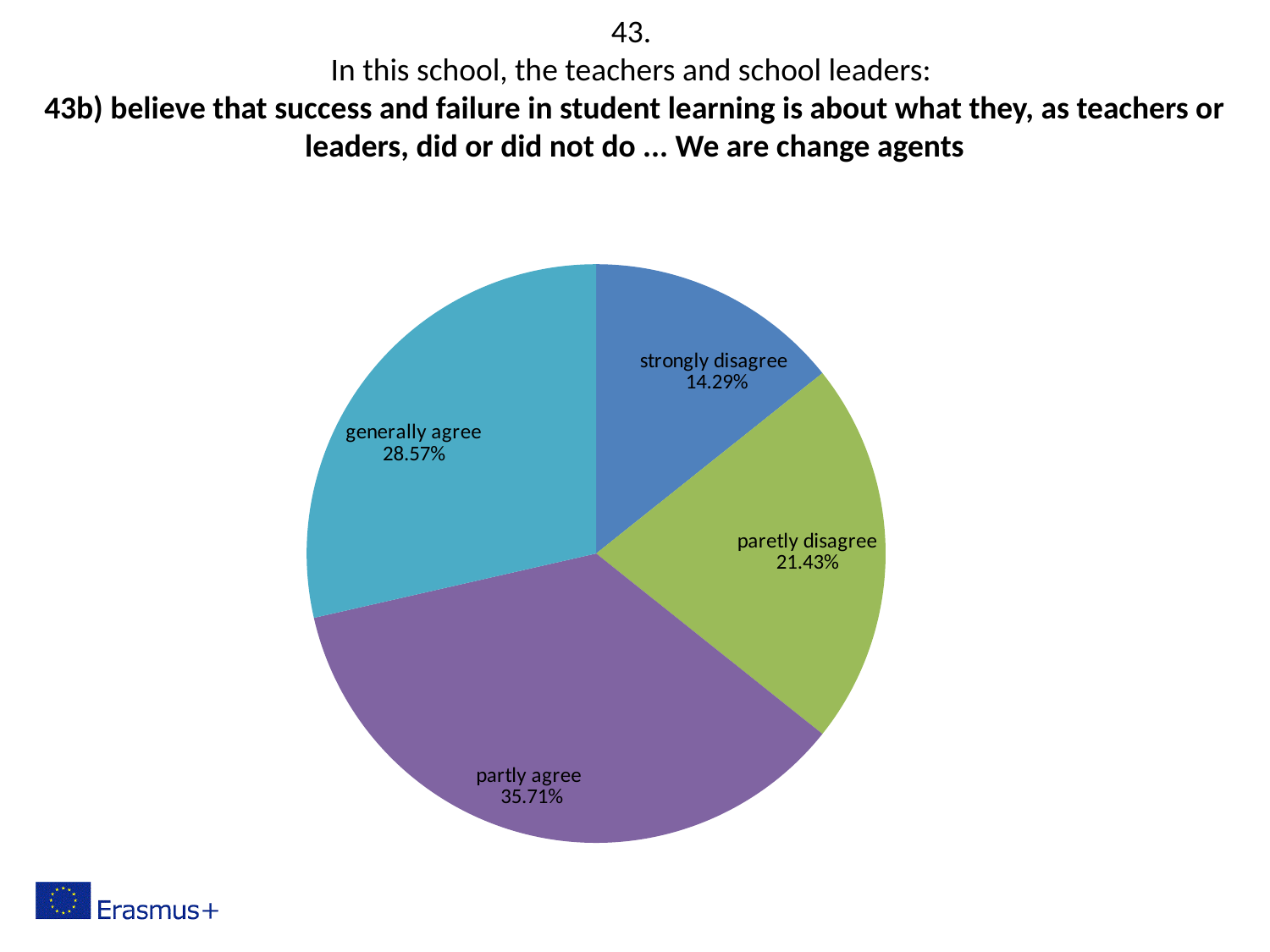
What share of the pie is labelled "partly agree"? 35.71% What share of the pie is labelled "strongly disagree"? 14.29% What share of the pie is labelled "paretly disagree"? 21.43% What kind of chart is shown on the slide? pie chart What is the difference between the "partly agree" and "generally agree" shares? 7.14% What colour is the "partly agree" slice? purple How many slices does the pie chart have? 4 Which is larger, the "generally agree" slice or the "paretly disagree" slice? generally agree What is the difference between the "paretly disagree" and "strongly disagree" shares? 7.14% Which slice of the pie is the smallest? strongly disagree Which slice of the pie is the largest? partly agree